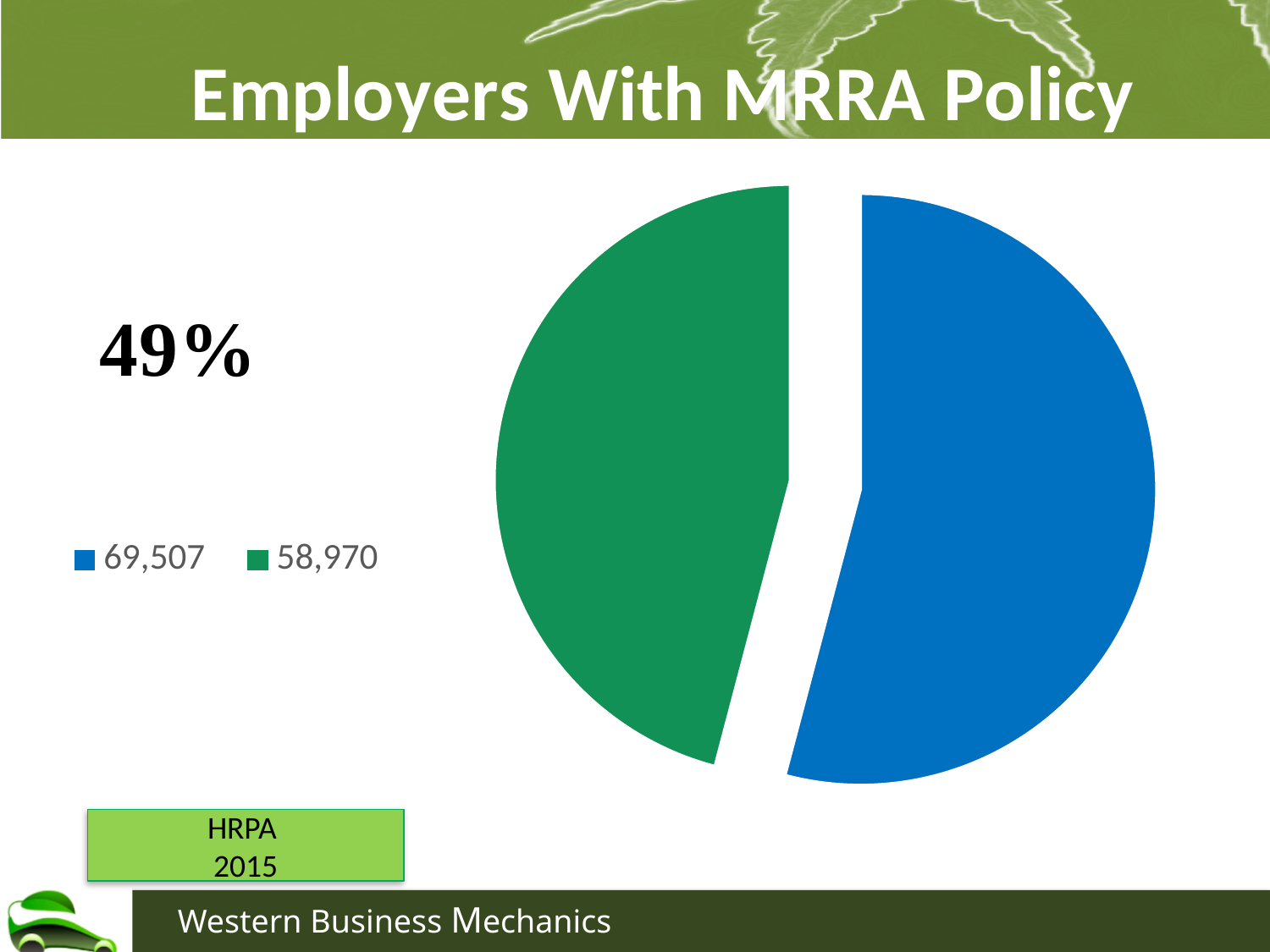
What is the difference between the two values shown in the legend, 69,507 and 58,970? 10,537 What is the title of the slide containing the pie chart? Employers With MRRA Policy Which slice of the pie chart is the largest? the blue slice (69,507) What value does the green slice of the pie chart represent? 58,970 How many entries does the legend list? 2 How many slices does the pie chart have? 2 Is the blue slice (69,507) larger or smaller than the green slice (58,970)? larger What kind of chart is shown on the slide? pie chart What percentage is printed in large text to the left of the pie chart? 49% What value does the blue slice of the pie chart represent? 69,507 Which slice of the pie chart is the smallest? the green slice (58,970) What is the total of the two values shown in the pie chart legend? 128,477